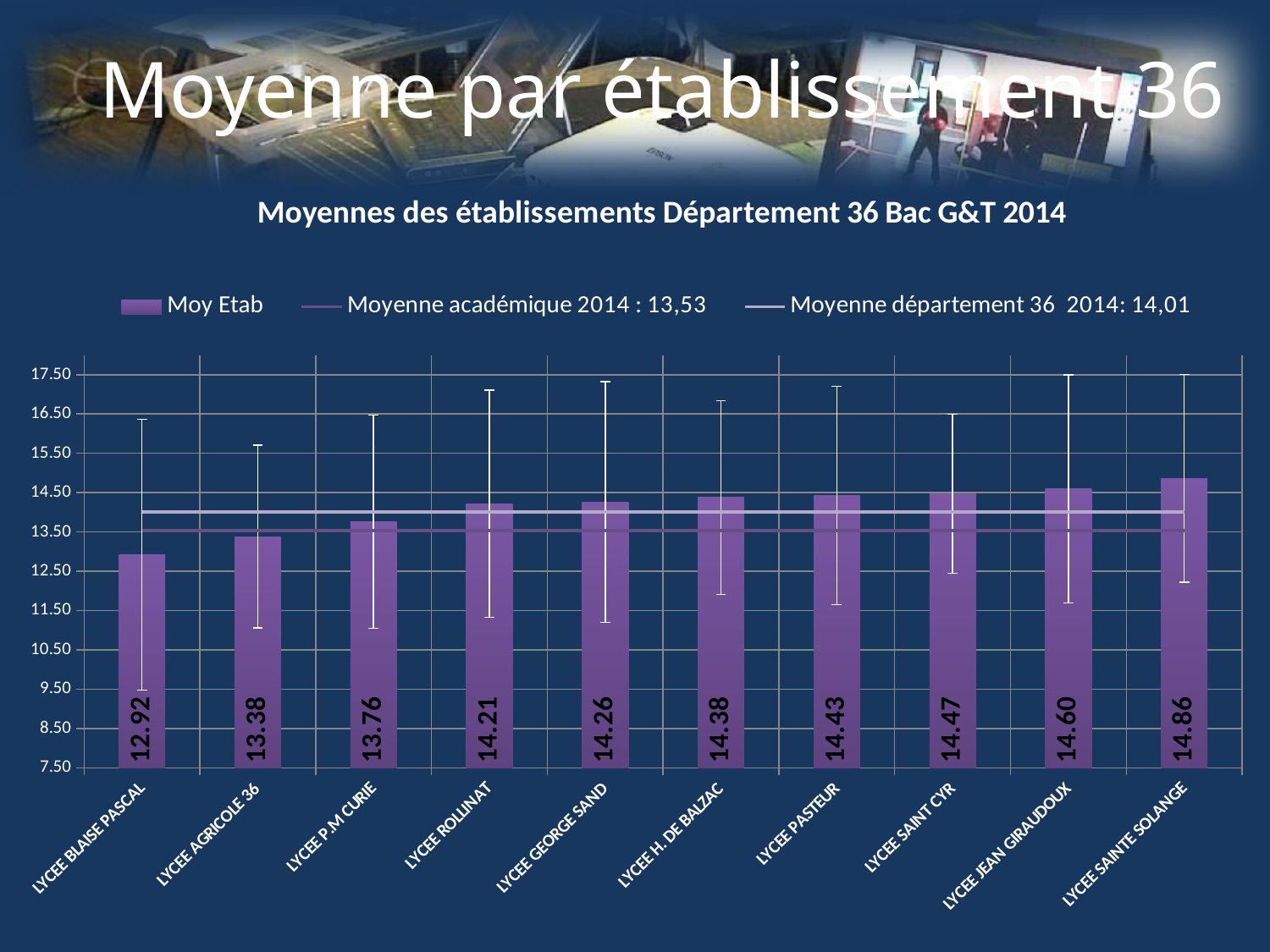
Is the value for LYCEE AGRICOLE 36 greater or less than 13.50? less What kind of chart is shown? bar chart What is the value for LYCEE GEORGE SAND? 14.26 Which is larger, the value for LYCEE ROLLINAT or LYCEE P.M CURIE? LYCEE ROLLINAT How many establishments are shown on the x axis? 10 Which establishment has the highest average? LYCEE SAINTE SOLANGE Do the bar values rise or fall from left to right along the x axis? rise What is the value for LYCEE BLAISE PASCAL? 12.92 What is the difference between the values for LYCEE SAINTE SOLANGE and LYCEE BLAISE PASCAL? 1.94 How many entries does the legend list? 3 What is the value for LYCEE SAINT CYR? 14.47 Which establishment has the lowest average? LYCEE BLAISE PASCAL